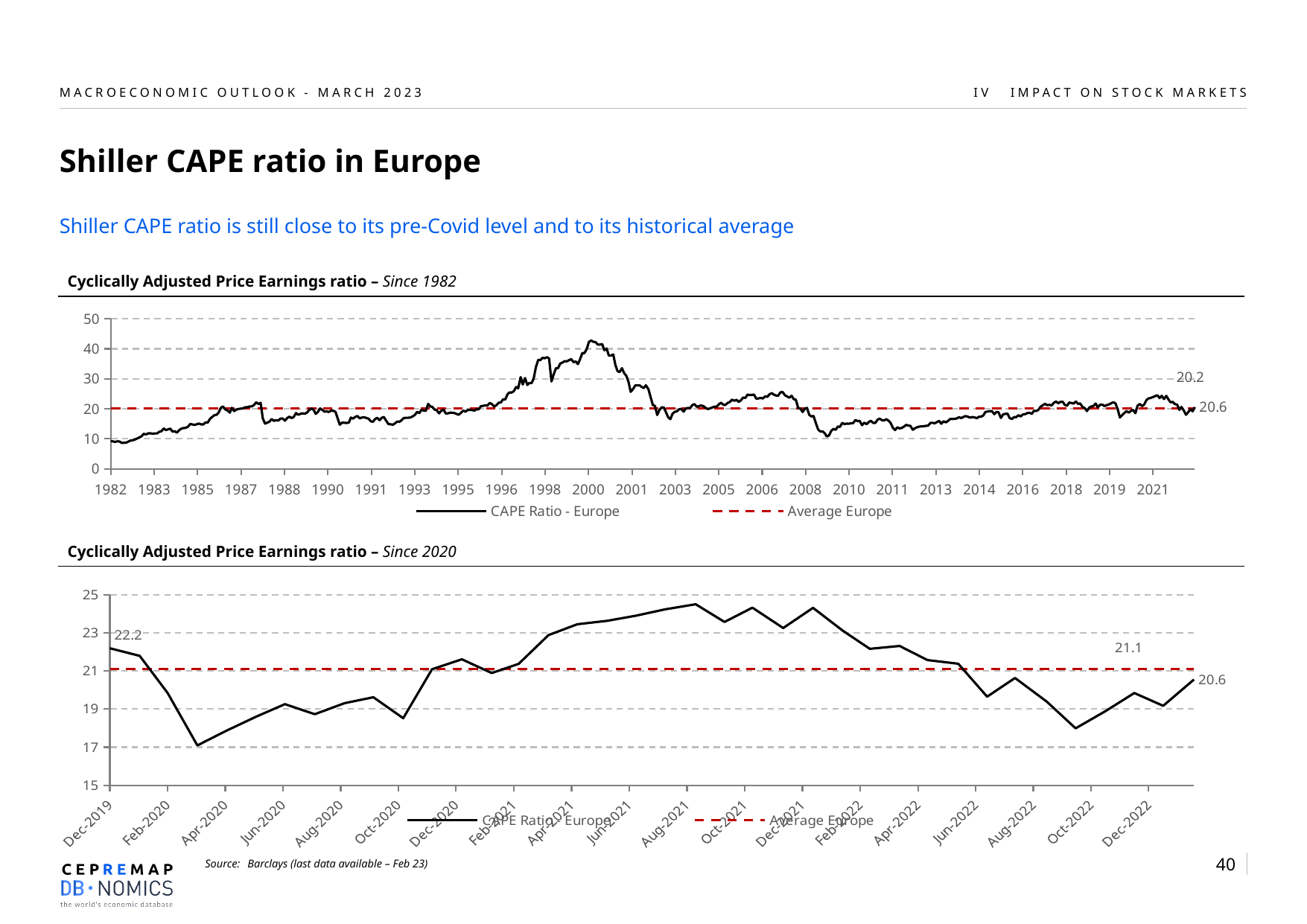
In the bottom chart (Since 2020), does the CAPE Ratio - Europe line rise or fall between Dec-2019 and Apr-2020? Fall In the bottom chart (Since 2020), what is the difference between the Dec-2019 value (22.2) and the latest labelled value (20.6)? 1.6 In the bottom chart (Since 2020), what is the labelled CAPE Ratio - Europe value at Dec-2019? 22.2 How many series does the legend of the top chart (Since 1982) list? 2 In the top chart (Since 1982), what is the latest labelled value of the CAPE Ratio - Europe line? 20.6 What kind of chart is the top chart, 'Cyclically Adjusted Price Earnings ratio – Since 1982'? Line chart In the bottom chart (Since 2020), is the CAPE Ratio - Europe value at Apr-2020 greater or less than 19? less In the bottom chart (Since 2020), what is the value of the Average Europe line? 21.1 In the top chart (Since 1982), is the peak of the CAPE Ratio - Europe line around 2000 greater or less than 40? greater In the top chart (Since 1982), what is the value of the Average Europe line? 20.2 In the bottom chart (Since 2020), which is larger: the Dec-2019 value or the latest labelled value? Dec-2019 value In the top chart (Since 1982), is the CAPE Ratio - Europe value in 2009 greater or less than 20? less